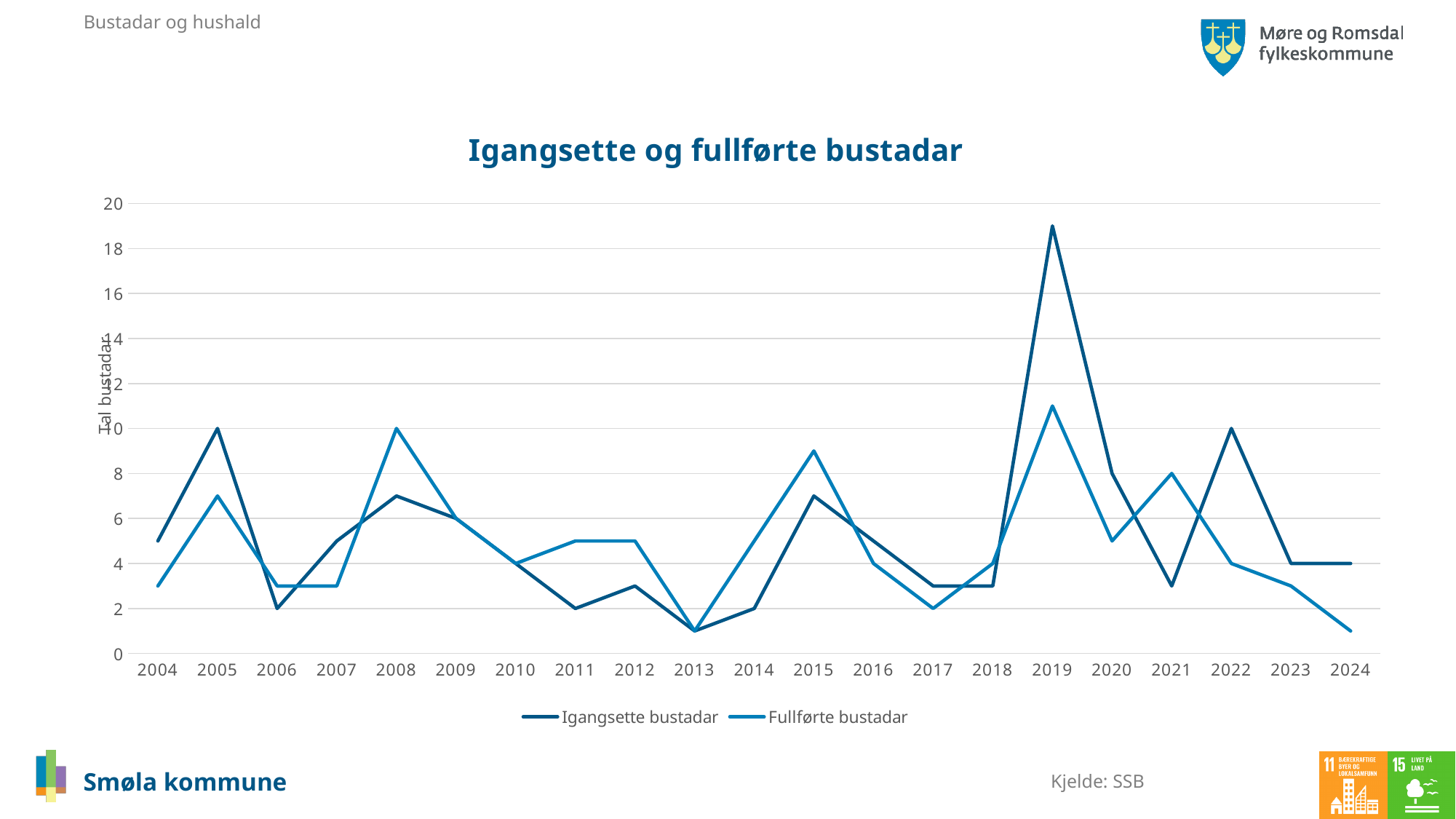
What is the difference between Igangsette bustadar and Fullførte bustadar in 2022? 6 Is the value for Igangsette bustadar in 2019 greater or less than 18? greater Does Fullførte bustadar rise or fall from 2021 to 2024? fall In which year is Igangsette bustadar highest? 2019 How many series does the legend list? 2 What is the value for Igangsette bustadar in 2005? 10 Which series has the larger value in 2019, Igangsette bustadar or Fullførte bustadar? Igangsette bustadar What is the value for Igangsette bustadar in 2020? 8 What kind of chart is shown on the slide? line chart What is the value for Fullførte bustadar in 2021? 8 How many years are shown on the x axis? 21 What is the value for Fullførte bustadar in 2008? 10